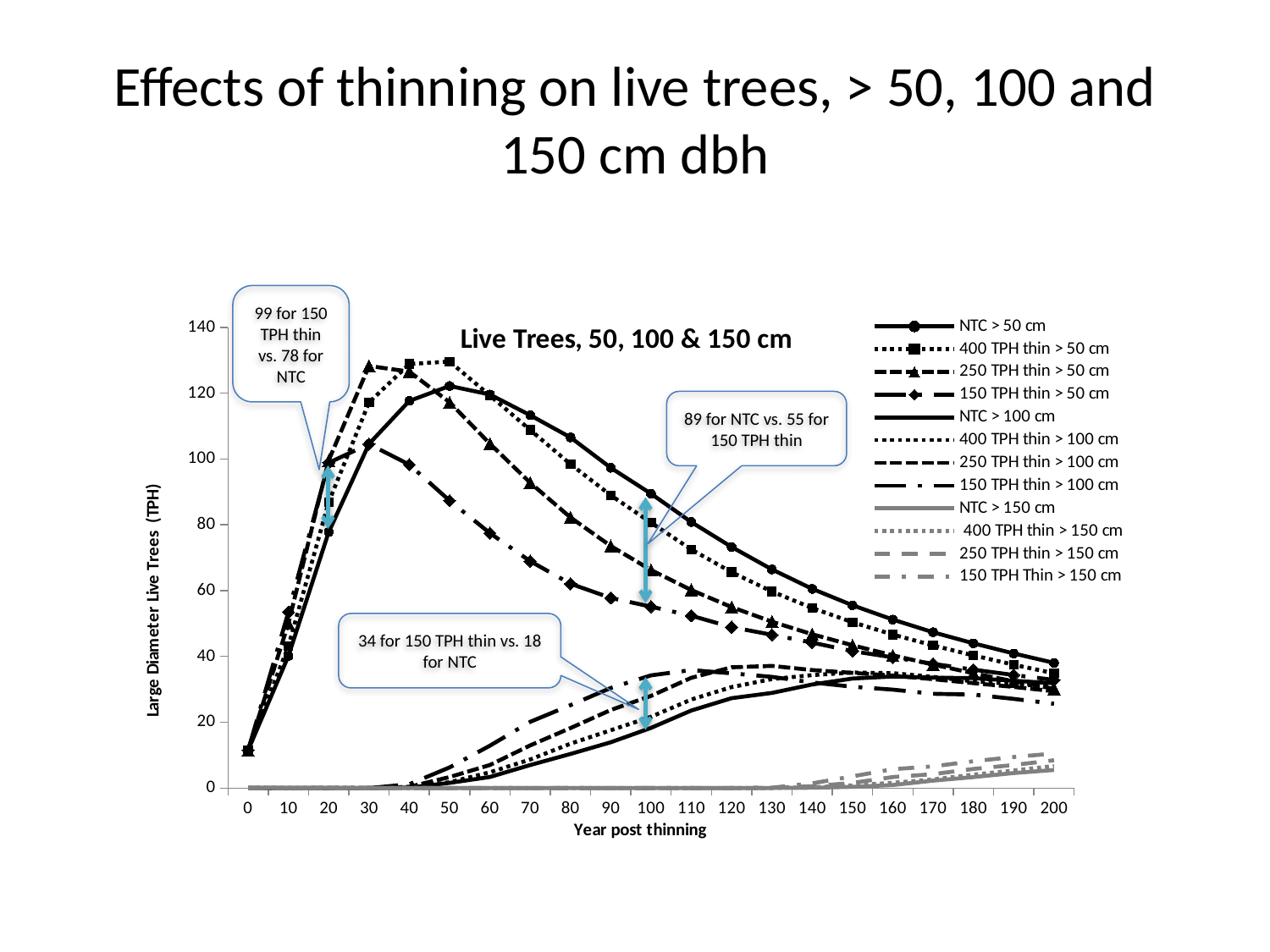
What is the x-axis label of the chart? Year post thinning According to the callout, what is the value for NTC > 50 cm at year 20? 78 What kind of chart is shown on the slide? line chart According to the callout, what is the value for 150 TPH thin > 100 cm at year 100? 34 At year 100, which is larger: NTC > 50 cm or 150 TPH thin > 50 cm? NTC > 50 cm What is the difference between NTC > 50 cm (89) and 150 TPH thin > 50 cm (55) at year 100? 34 According to the callout, what is the value for 150 TPH thin > 50 cm at year 20? 99 According to the callout, what is the value for NTC > 50 cm at year 100? 89 How many series does the chart legend list? 12 What is the difference between the 150 TPH thin > 50 cm value (99) and the NTC > 50 cm value (78) at year 20? 21 What is the title printed inside the chart area? Live Trees, 50, 100 & 150 cm Is the value for NTC > 50 cm at year 0 greater or less than 20? less